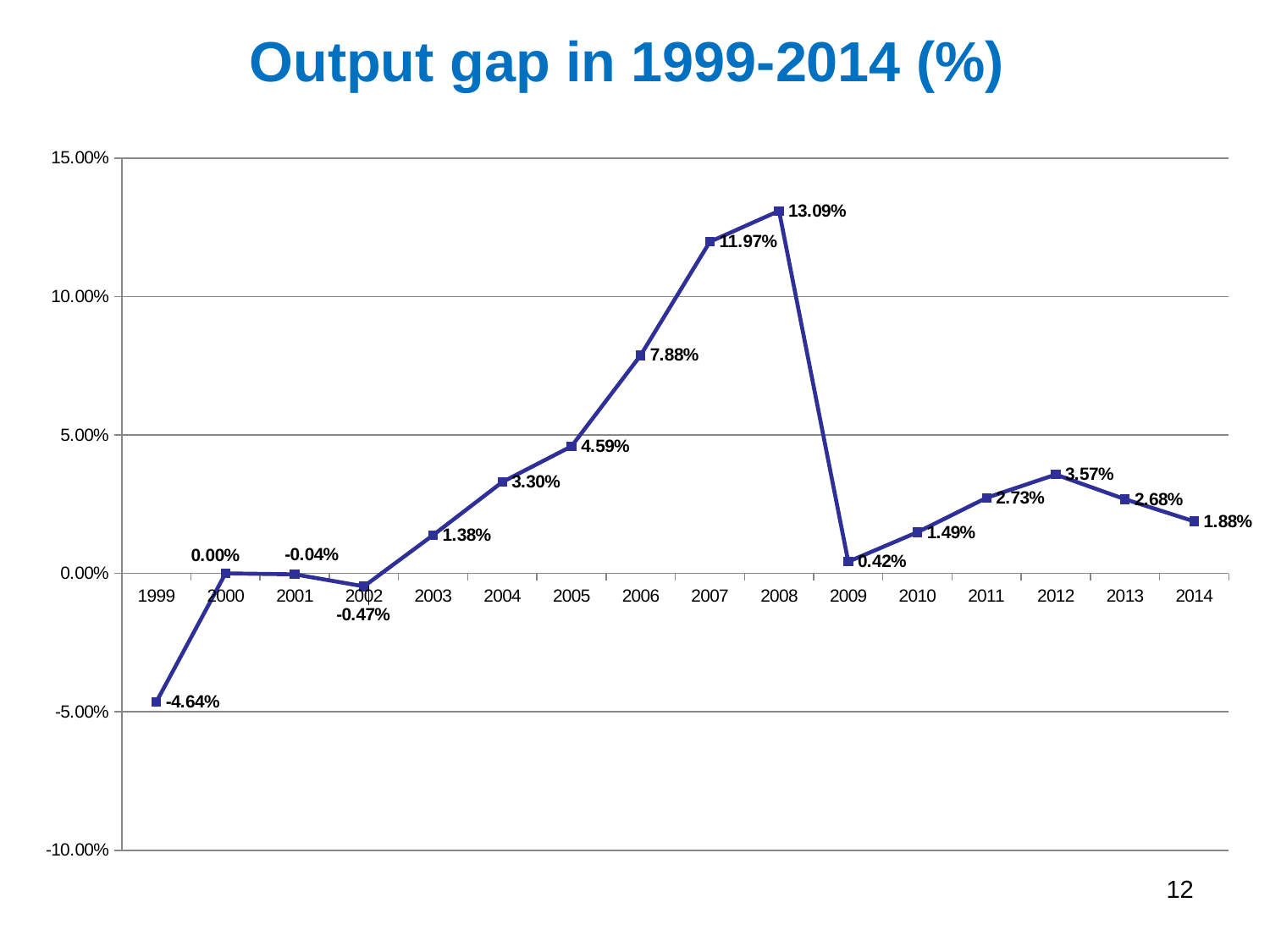
What is the difference between the output gap in 2008 and in 2007? 1.12% Which year has a larger output gap, 2006 or 2005? 2006 Which year has the lowest output gap? 1999 Does the output gap rise or fall from 2012 to 2014? Fall How many years are plotted on the chart? 16 What is the output gap value for 2008? 13.09% Which year has the highest output gap? 2008 What is the output gap value for 2012? 3.57% What is the output gap value for 1999? -4.64% Is the output gap value for 2007 greater or less than 10.00%? greater What kind of chart is shown on the slide? Line chart What is the title of the chart? Output gap in 1999-2014 (%)